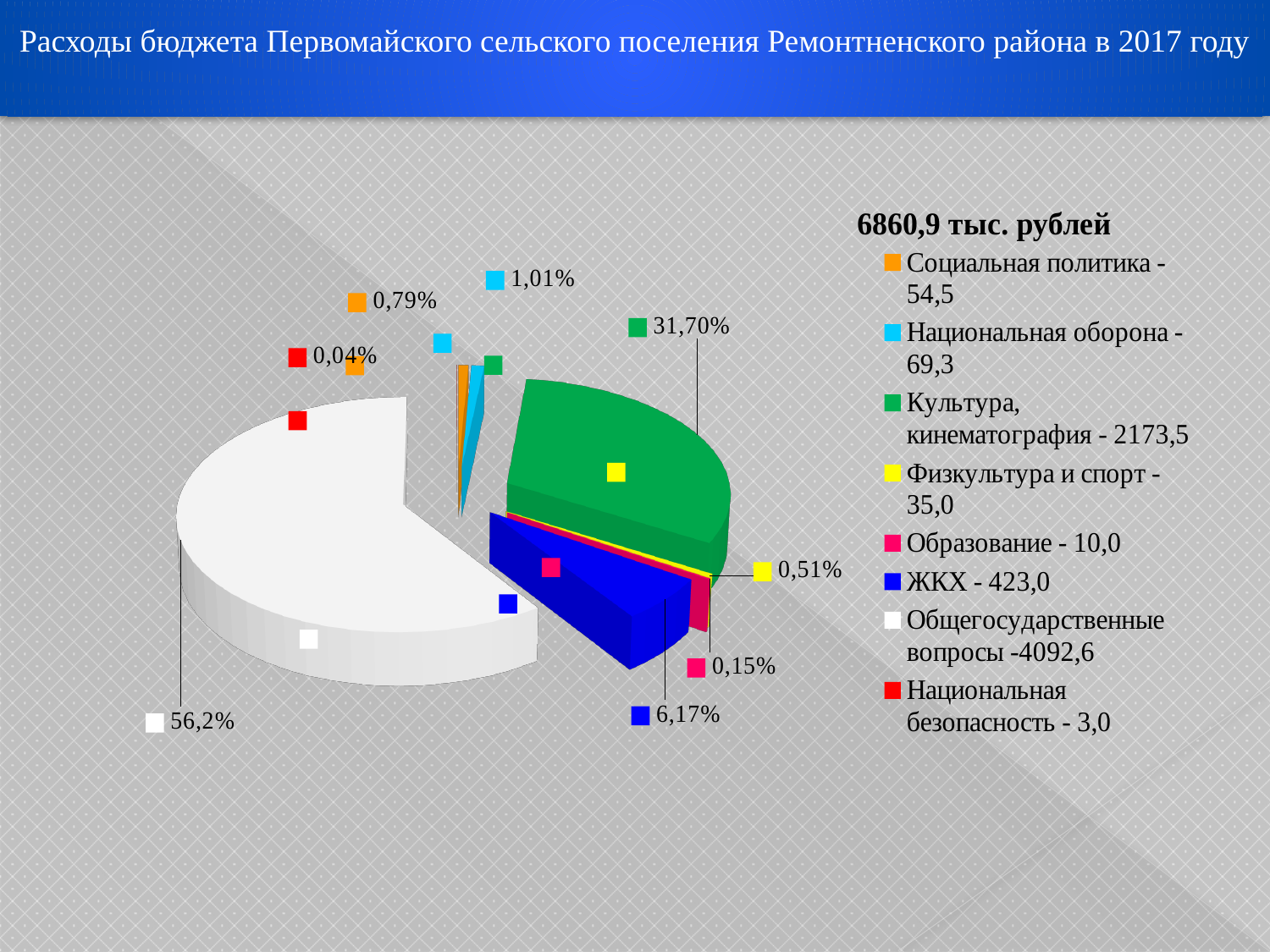
What is the title of the chart? 6860,9 тыс. рублей Which category has the smallest slice of the pie? Национальная безопасность Which is larger: the share for Социальная политика or the share for Физкультура и спорт? Социальная политика Which category has the largest slice of the pie? Общегосударственные вопросы What is the difference in percentage points between the shares of Культура, кинематография and ЖКХ? 25,53% What value is listed in the legend for Образование? 10,0 What share of the pie does ЖКХ have? 6,17% What share of the pie does Национальная оборона have? 1,01% What share of the pie does Культура, кинематография have? 31,70% What kind of chart is shown on the slide? pie chart How many categories does the pie chart show? 8